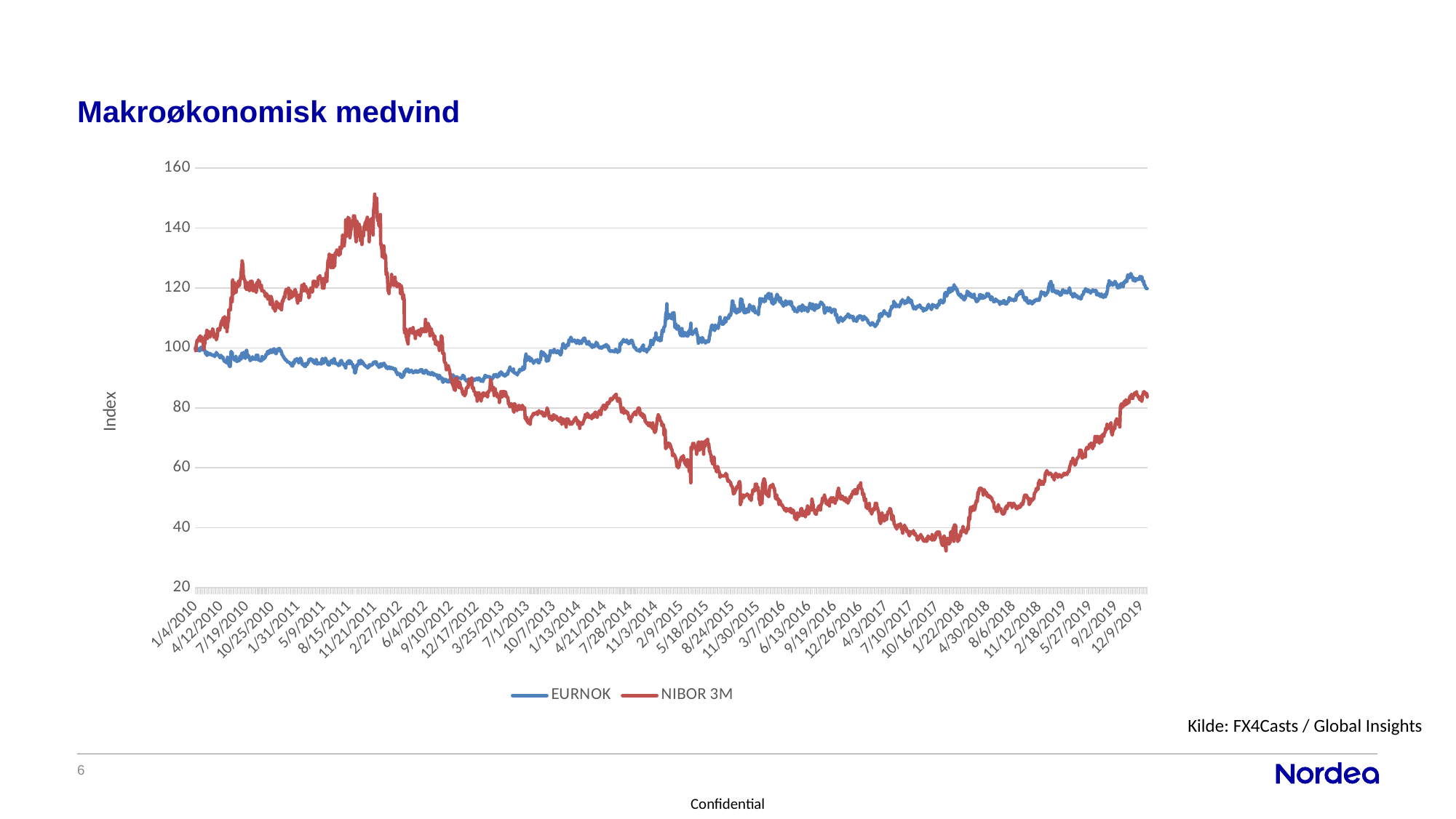
How many series does the legend list? 2 Is the value for NIBOR 3M at 11/21/2011 greater or less than 120? greater What is the label on the vertical axis? Index Does the NIBOR 3M series rise or fall between 1/22/2018 and 12/9/2019? Rise Is the value for NIBOR 3M at 12/9/2019 greater or less than 100? less At 11/21/2011, which series has the higher value, EURNOK or NIBOR 3M? NIBOR 3M Which series reaches the highest value anywhere on the chart? NIBOR 3M What are the two series named in the legend? EURNOK and NIBOR 3M Is the value for NIBOR 3M at 10/16/2017 greater or less than 60? less At 12/9/2019, which series has the higher value, EURNOK or NIBOR 3M? EURNOK What kind of chart is shown on the slide? Line chart